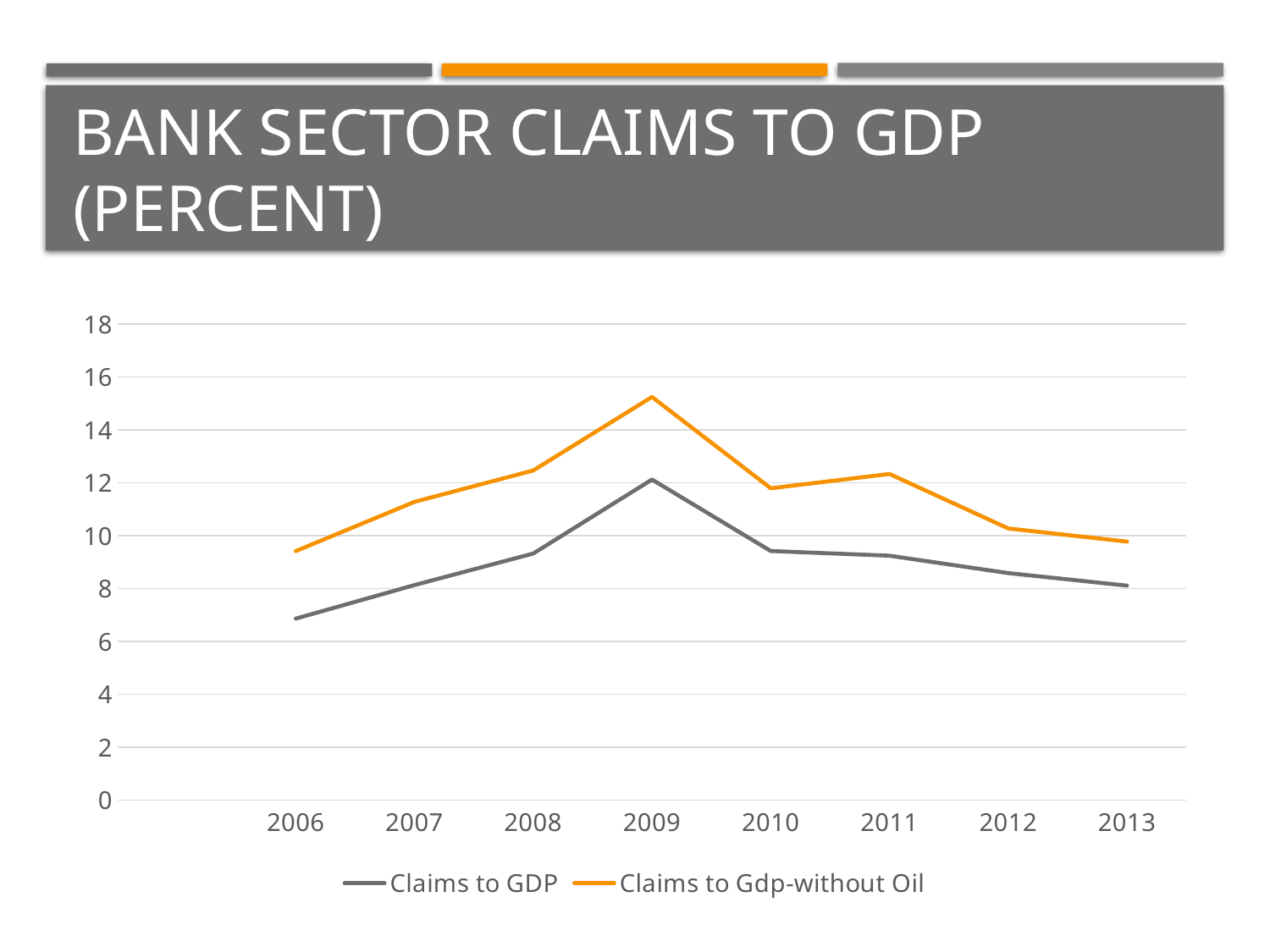
Is the value for Claims to GDP in 2013 greater or less than 10? less What is the title of the chart on the slide? BANK SECTOR CLAIMS TO GDP (PERCENT) Which series has the higher value in 2011, Claims to GDP or Claims to Gdp-without Oil? Claims to Gdp-without Oil What kind of chart is shown on the slide? line chart In which year does the Claims to GDP series reach its highest value? 2009 In which year is the Claims to GDP series at its lowest value? 2006 How many years are shown on the x axis? 8 Do the values of the Claims to GDP series rise or fall from 2009 to 2013? fall How many series does the legend list? 2 Is the value for Claims to GDP in 2006 greater or less than 8? less Is the value for Claims to Gdp-without Oil in 2009 greater or less than 14? greater In which year does the Claims to Gdp-without Oil series reach its highest value? 2009